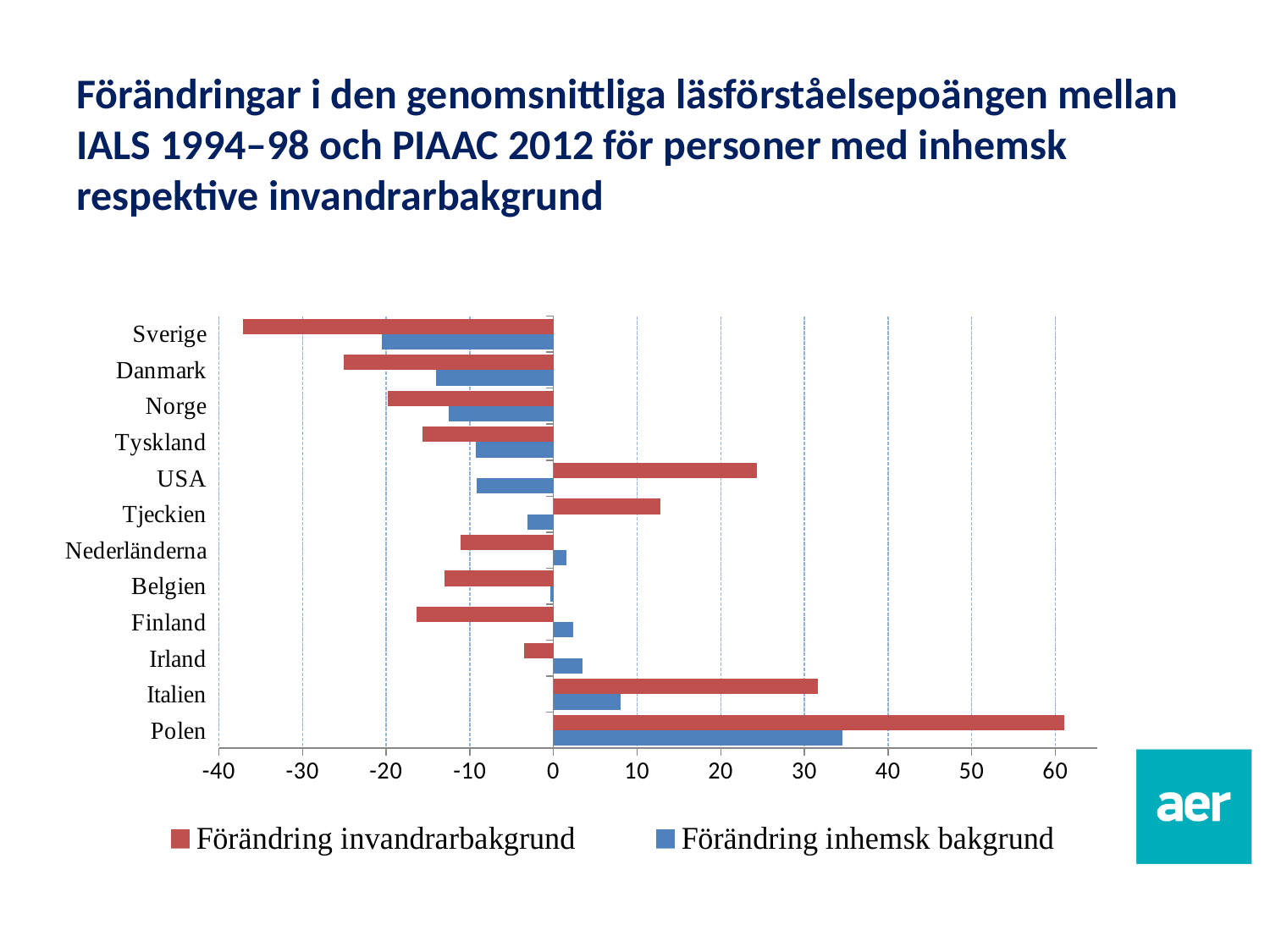
Is the value for USA in the Förändring invandrarbakgrund series greater or less than 20? greater Is the value for Sverige in the Förändring invandrarbakgrund series greater or less than -30? less What colour are the bars for the Förändring invandrarbakgrund series? red Is the value for Polen in the Förändring invandrarbakgrund series greater or less than 50? greater How many countries are listed on the chart? 12 Which country has the highest value for Förändring inhemsk bakgrund? Polen What kind of chart is shown on the slide? bar chart Which country has the lowest value for Förändring invandrarbakgrund? Sverige Which has the larger value for Förändring invandrarbakgrund, Italien or USA? Italien How many series does the legend list? 2 Which country has the lowest value for Förändring inhemsk bakgrund? Sverige Which country has the highest value for Förändring invandrarbakgrund? Polen